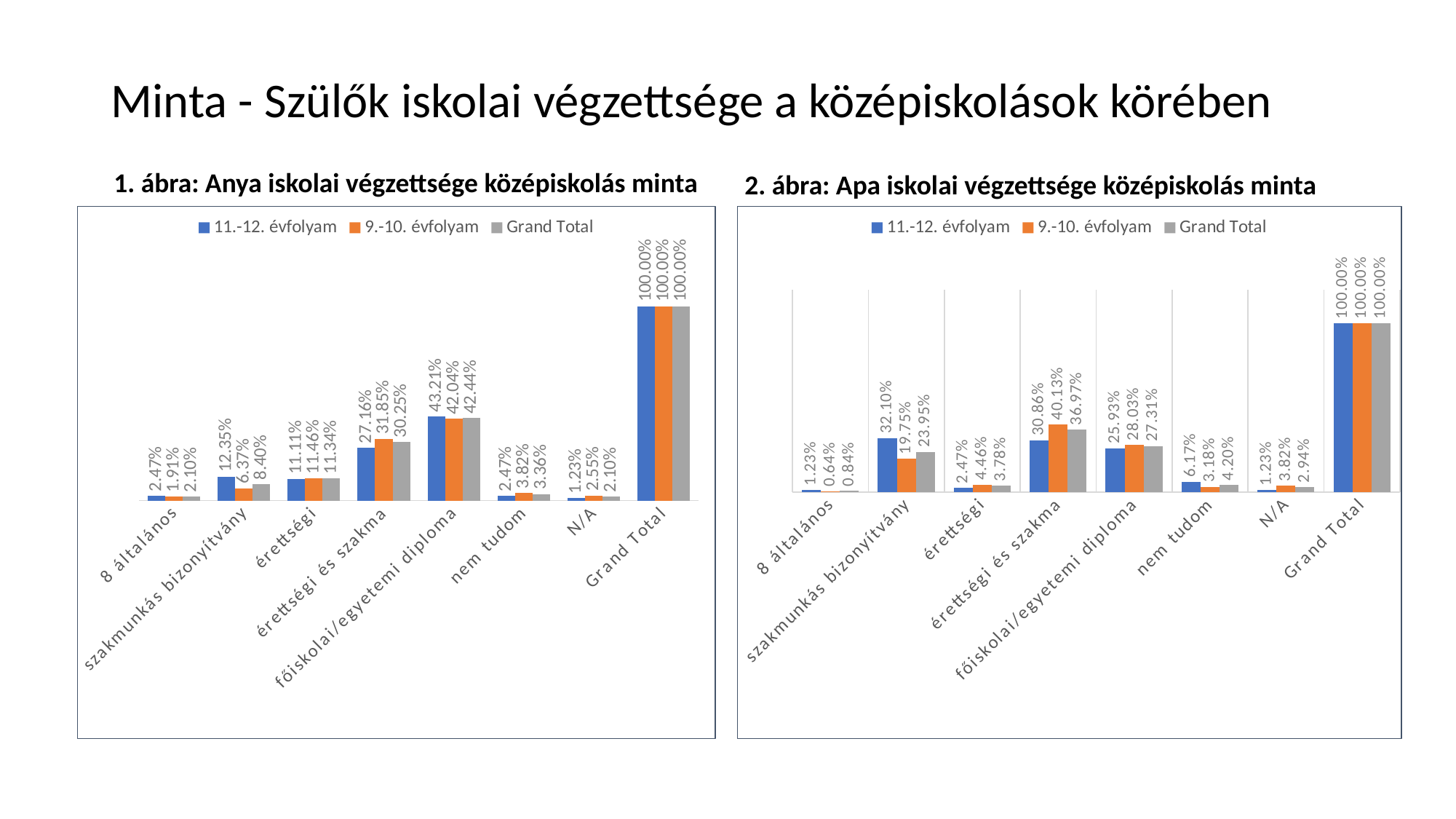
In the chart '1. ábra: Anya iskolai végzettsége középiskolás minta', what is the Grand Total value for 'főiskolai/egyetemi diploma'? 42.44% In the chart '1. ábra: Anya iskolai végzettsége középiskolás minta', what is the difference between the 9.-10. évfolyam and 11.-12. évfolyam values for 'érettségi és szakma'? 4.69% How many categories are shown on the x axis of the chart '2. ábra: Apa iskolai végzettsége középiskolás minta'? 8 In the chart '2. ábra: Apa iskolai végzettsége középiskolás minta', what is the difference between the 11.-12. évfolyam and 9.-10. évfolyam values for 'szakmunkás bizonyítvány'? 12.35% In the chart '2. ábra: Apa iskolai végzettsége középiskolás minta', what is the 9.-10. évfolyam value for 'érettségi és szakma'? 40.13% In the chart '2. ábra: Apa iskolai végzettsége középiskolás minta', excluding Grand Total, which category has the lowest Grand Total value? 8 általános In the chart '1. ábra: Anya iskolai végzettsége középiskolás minta', how many series does the legend list? 3 In the chart '2. ábra: Apa iskolai végzettsége középiskolás minta', which is larger for 'nem tudom': the 11.-12. évfolyam value or the 9.-10. évfolyam value? 11.-12. évfolyam What type of chart is '1. ábra: Anya iskolai végzettsége középiskolás minta'? Bar chart In the chart '2. ábra: Apa iskolai végzettsége középiskolás minta', what is the Grand Total value for 'szakmunkás bizonyítvány'? 23.95% In the chart '1. ábra: Anya iskolai végzettsége középiskolás minta', what is the value for 'szakmunkás bizonyítvány' in the 11.-12. évfolyam series? 12.35% In the chart '1. ábra: Anya iskolai végzettsége középiskolás minta', excluding Grand Total, which category has the highest Grand Total value? főiskolai/egyetemi diploma